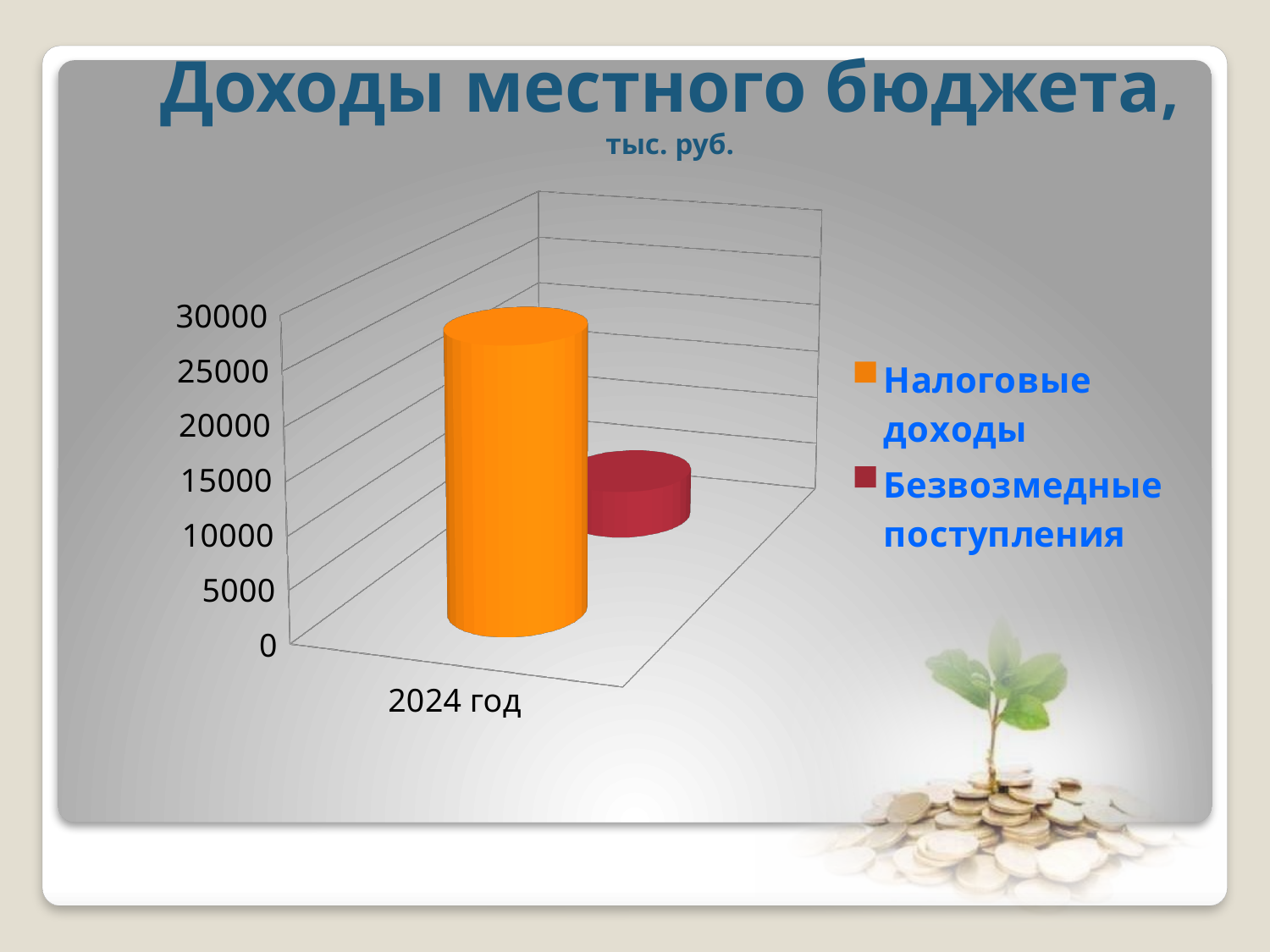
Which category is shown on the x axis? 2024 год What kind of chart is shown on the slide? bar chart Which series has the lowest value in the chart? Безвозмездные поступления How many series does the legend list? 2 Is the value for Безвозмездные поступления greater or less than 10000? less Which series has the highest value in the chart? Налоговые доходы What is the title of the chart? Доходы местного бюджета, тыс. руб. Which series has the larger value for 2024 год: Налоговые доходы or Безвозмездные поступления? Налоговые доходы Is the value for Налоговые доходы greater or less than 20000? greater What is the highest value shown on the vertical axis? 30000 How many categories are shown on the x axis? 1